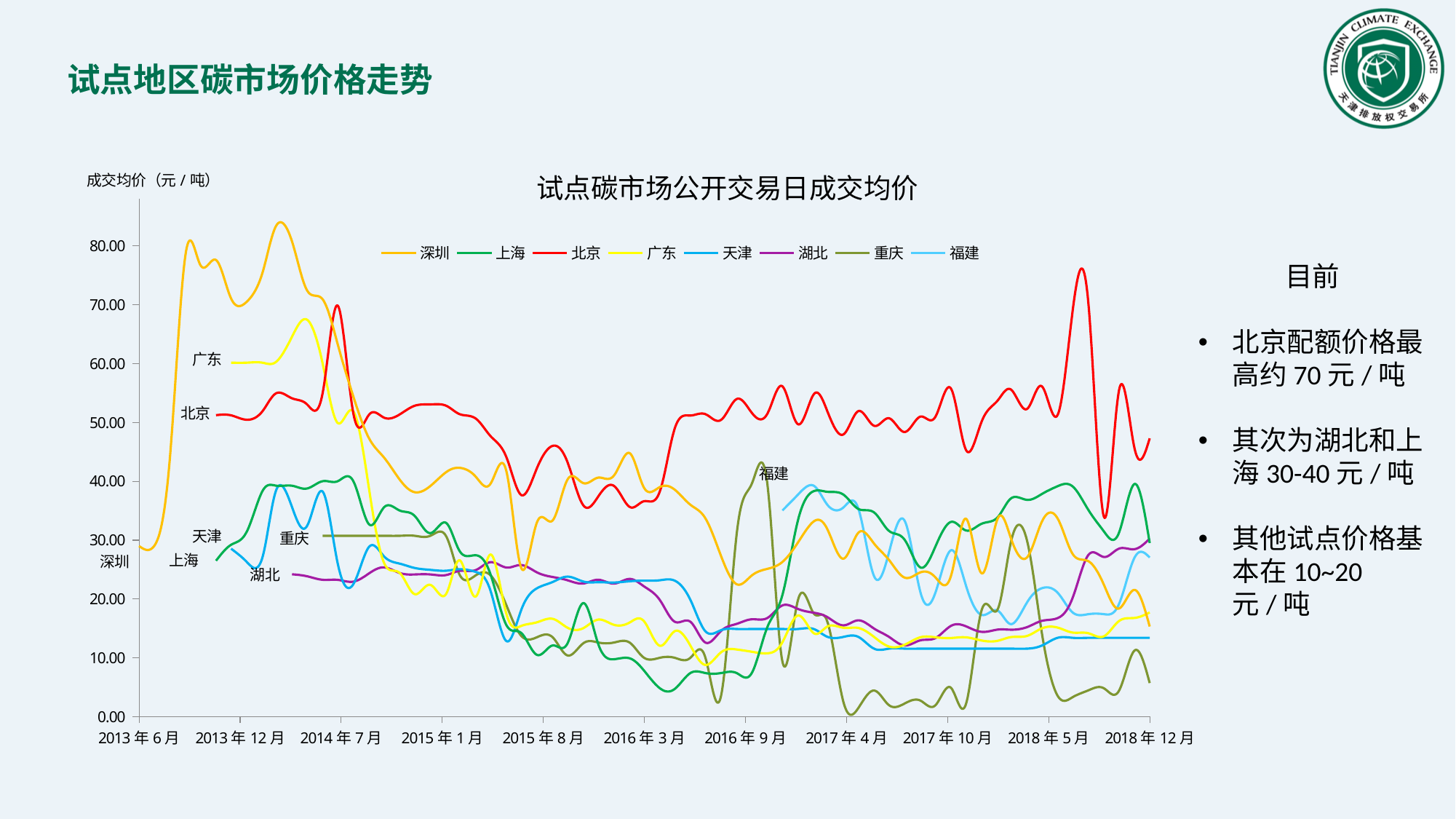
Is the value for 北京 at 2018年12月 greater or less than 40.00? greater Which series reaches the highest value anywhere on the chart? 深圳 At 2018年12月, which is larger, the value for 北京 or the value for 上海? 北京 Which series has the lowest value at 2018年12月? 重庆 Which series has the highest value at 2018年12月? 北京 Is the value for 广东 at 2013年12月 greater or less than 50.00? greater Does the 深圳 line end at 2018年12月 higher or lower than it starts at 2013年6月? lower Is the value for 重庆 at 2018年12月 greater or less than 10.00? less What is the title of the chart? 试点碳市场公开交易日成交均价 How many series does the chart legend list? 8 What colour is the 北京 line in the chart? red What kind of chart is shown on the slide? line chart